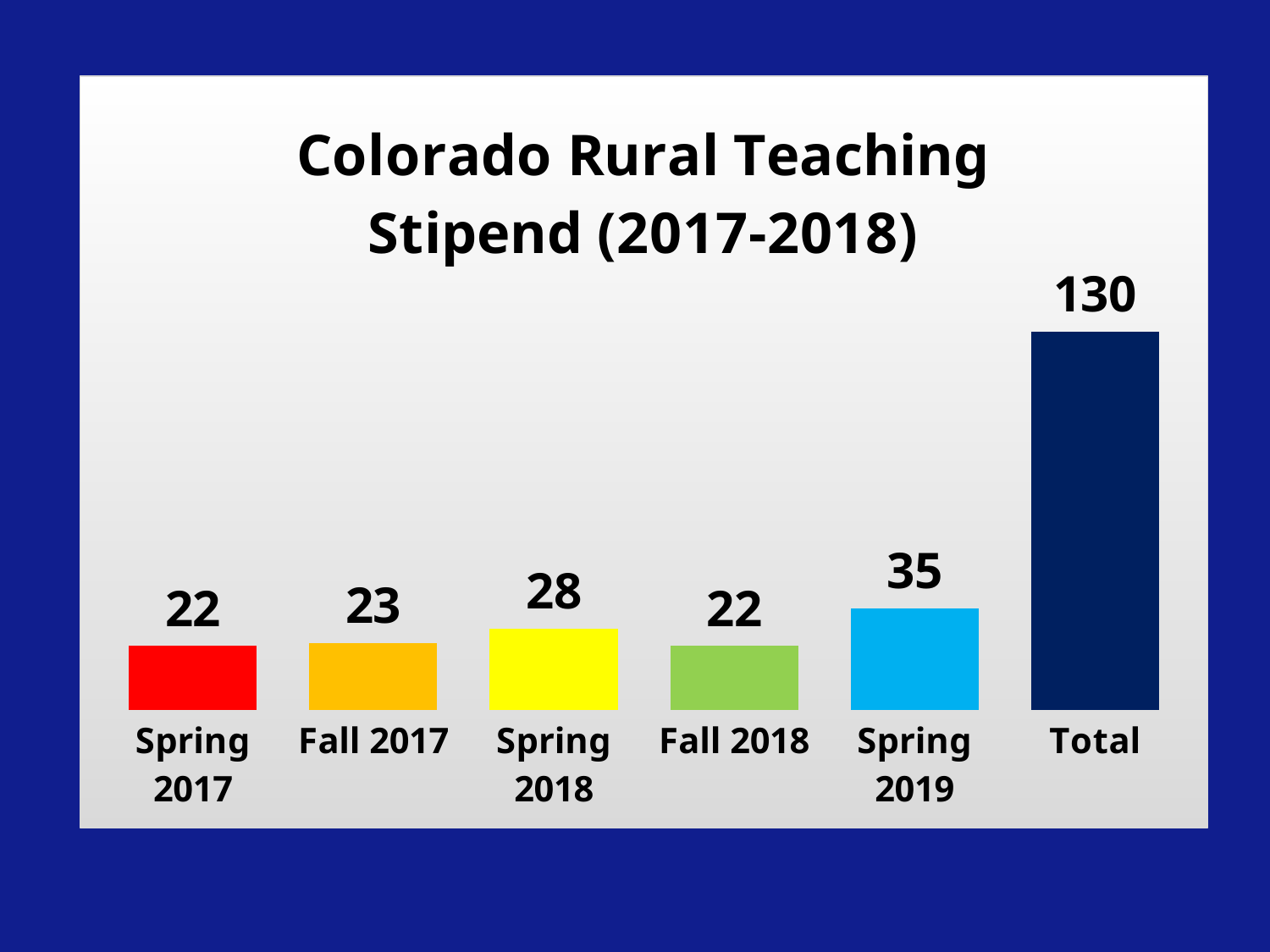
Excluding the Total bar, which semester has the highest value? Spring 2019 What is the value for Spring 2018? 28 What is the value for Spring 2019? 35 What kind of chart is shown on the slide? Bar chart What is the difference between the values for Spring 2019 and Spring 2018? 7 What is the value for the Total bar? 130 Which is larger, the value for Fall 2017 or the value for Fall 2018? Fall 2017 How many bars are shown in the chart? 6 What is the title of the chart? Colorado Rural Teaching Stipend (2017-2018) What is the value for Fall 2017? 23 Which category has the highest value? Total What is the value for Spring 2017? 22